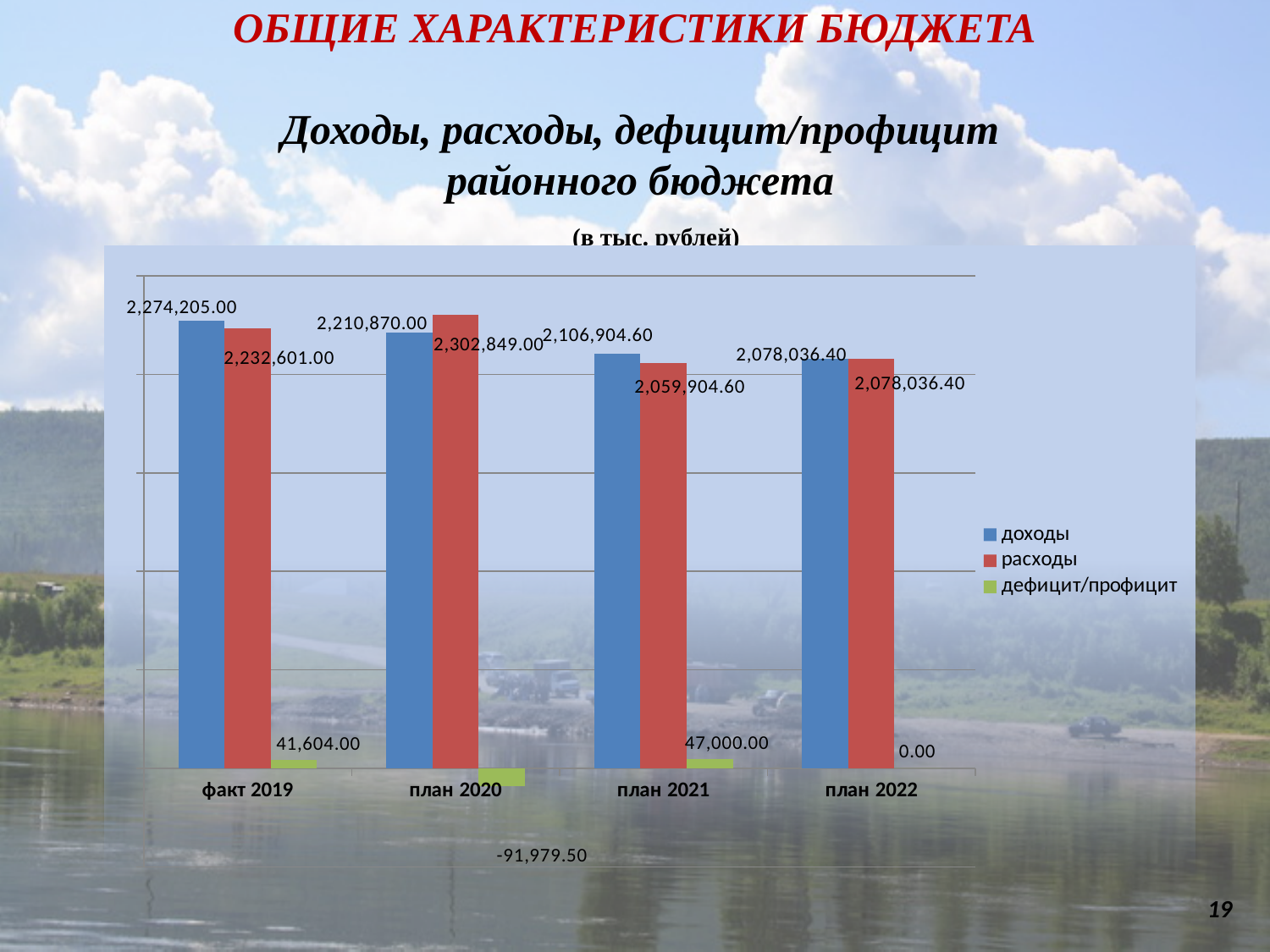
Which is larger for план 2020, доходы or расходы? расходы Do the доходы values rise or fall from факт 2019 to план 2022? fall What is the value of расходы for план 2020? 2,302,849.00 Which category has the lowest value of расходы? план 2021 What is the difference between доходы and расходы for факт 2019? 41,604.00 How many categories are shown on the x axis? 4 What type of chart is shown on the slide? bar chart What is the value of дефицит/профицит for план 2021? 47,000.00 Which category has the highest value of доходы? факт 2019 What is the value of дефицит/профицит for план 2020? -91,979.50 How many series does the legend list? 3 What is the value of доходы for факт 2019? 2,274,205.00